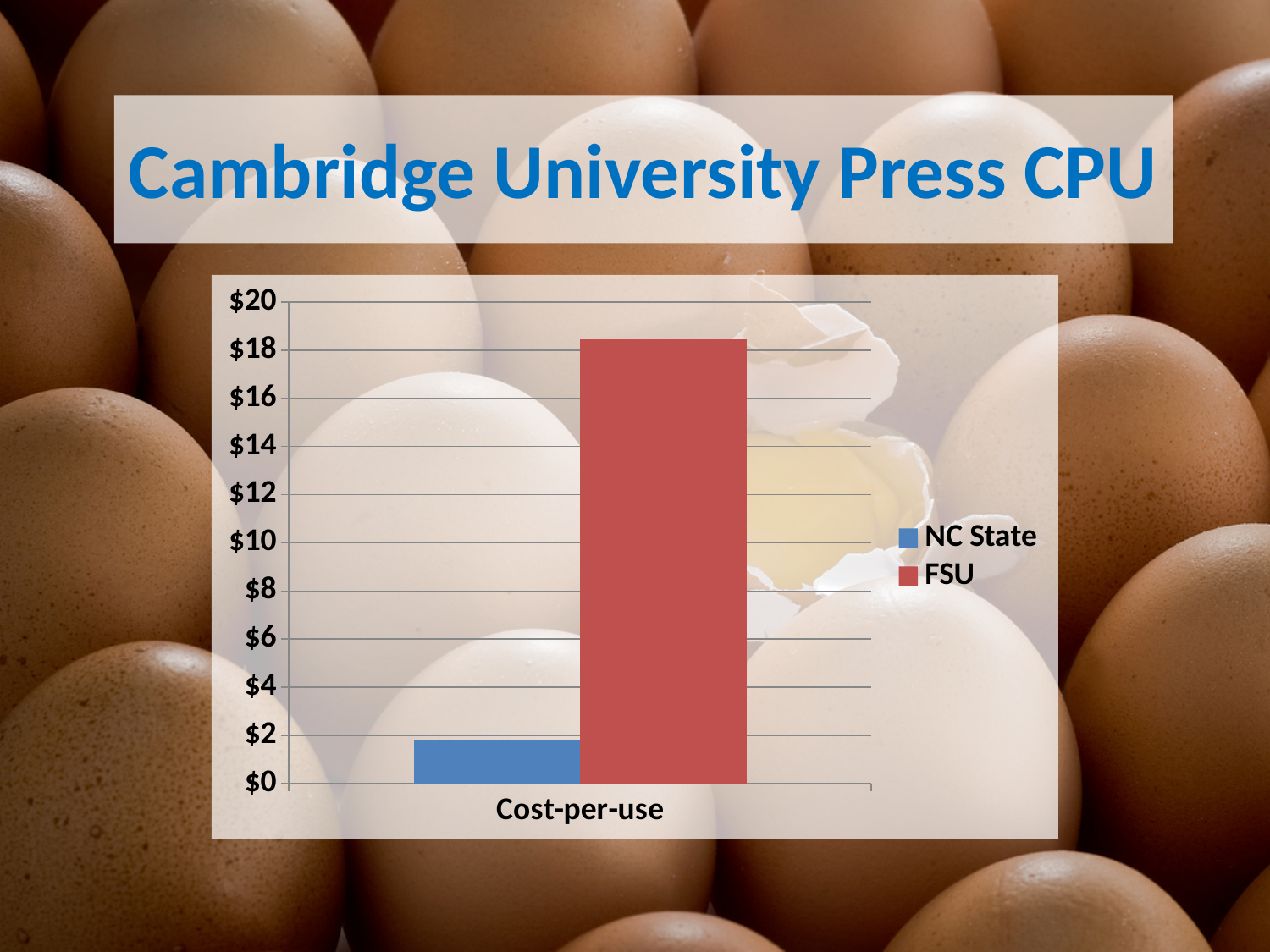
Is the cost-per-use value for FSU greater or less than $10? greater Which series has the highest cost-per-use? FSU How many series does the legend list? 2 Which series has the higher cost-per-use, NC State or FSU? FSU What colour is the bar for FSU? red What kind of chart is shown on the slide? bar chart How many categories are shown on the x axis? 1 Is the cost-per-use value for FSU greater or less than $16? greater What is the category label on the x axis? Cost-per-use Is the cost-per-use value for NC State greater or less than $2? less Which series has the lowest cost-per-use? NC State What is the highest value shown on the y axis? $20